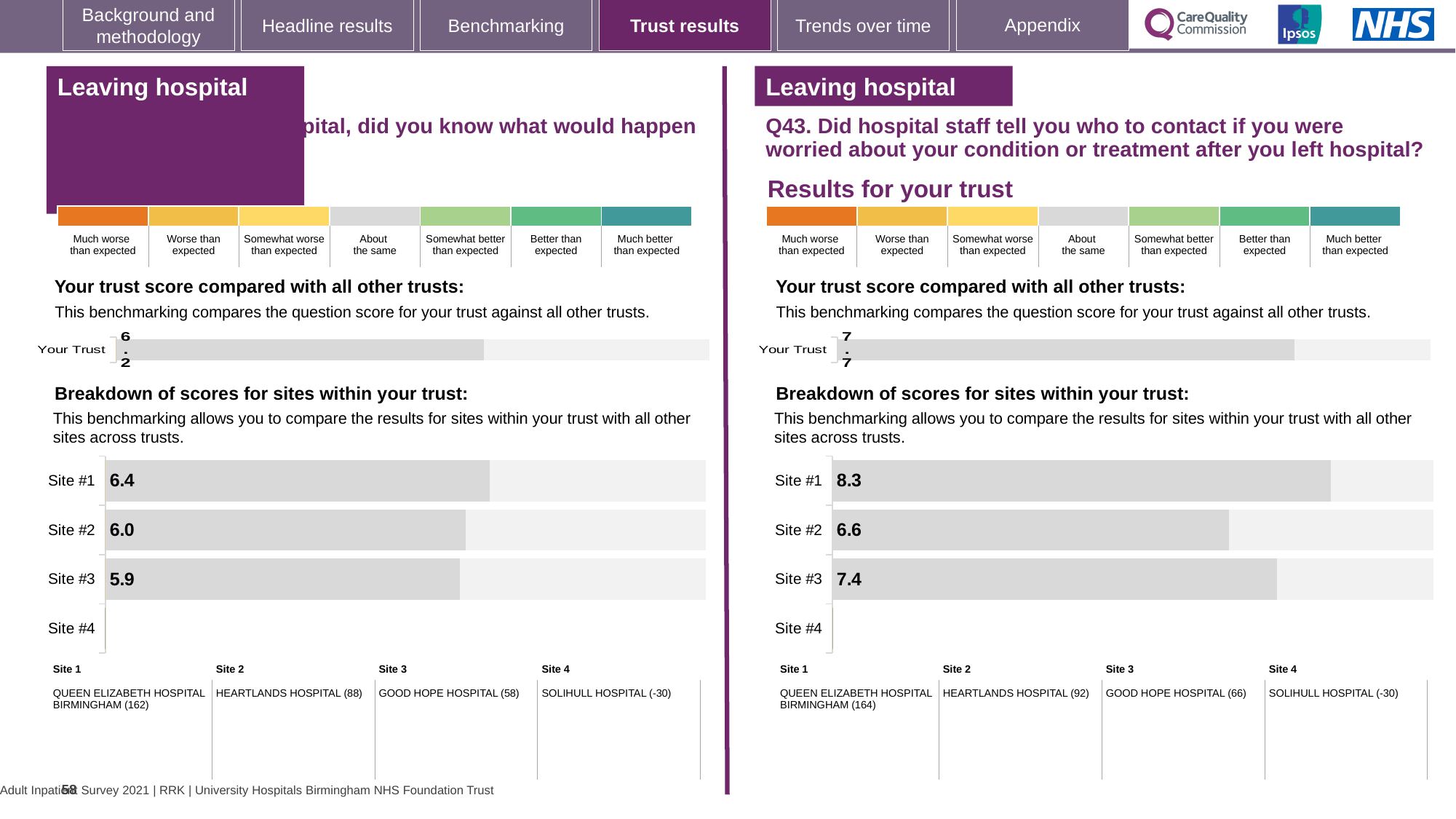
On the right-hand (Q43) 'Breakdown of scores for sites within your trust' chart, what is the score for Site #1? 8.3 What kind of chart is the right-hand (Q43) 'Breakdown of scores for sites within your trust' chart? Bar chart On the left-hand 'Breakdown of scores for sites within your trust' chart, what is the score for Site #3? 5.9 On the right-hand (Q43) 'Breakdown of scores for sites within your trust' chart, what is the score for Site #2? 6.6 On the right-hand (Q43) 'Breakdown of scores for sites within your trust' chart, which site has the highest score? Site #1 On the left-hand 'Breakdown of scores for sites within your trust' chart, what is the difference between the scores for Site #1 and Site #3? 0.5 On the right-hand (Q43) 'Breakdown of scores for sites within your trust' chart, which site has the lowest score among those with a bar shown? Site #2 On the left-hand 'Breakdown of scores for sites within your trust' chart, which has the larger score, Site #2 or Site #3? Site #2 On the right-hand (Q43) 'Breakdown of scores for sites within your trust' chart, what is the score for Site #3? 7.4 On the left-hand 'Breakdown of scores for sites within your trust' chart, what is the score for Site #1? 6.4 On the left-hand 'Breakdown of scores for sites within your trust' chart, which site has the highest score? Site #1 On the right-hand (Q43) 'Breakdown of scores for sites within your trust' chart, what is the difference between the scores for Site #1 and Site #2? 1.7